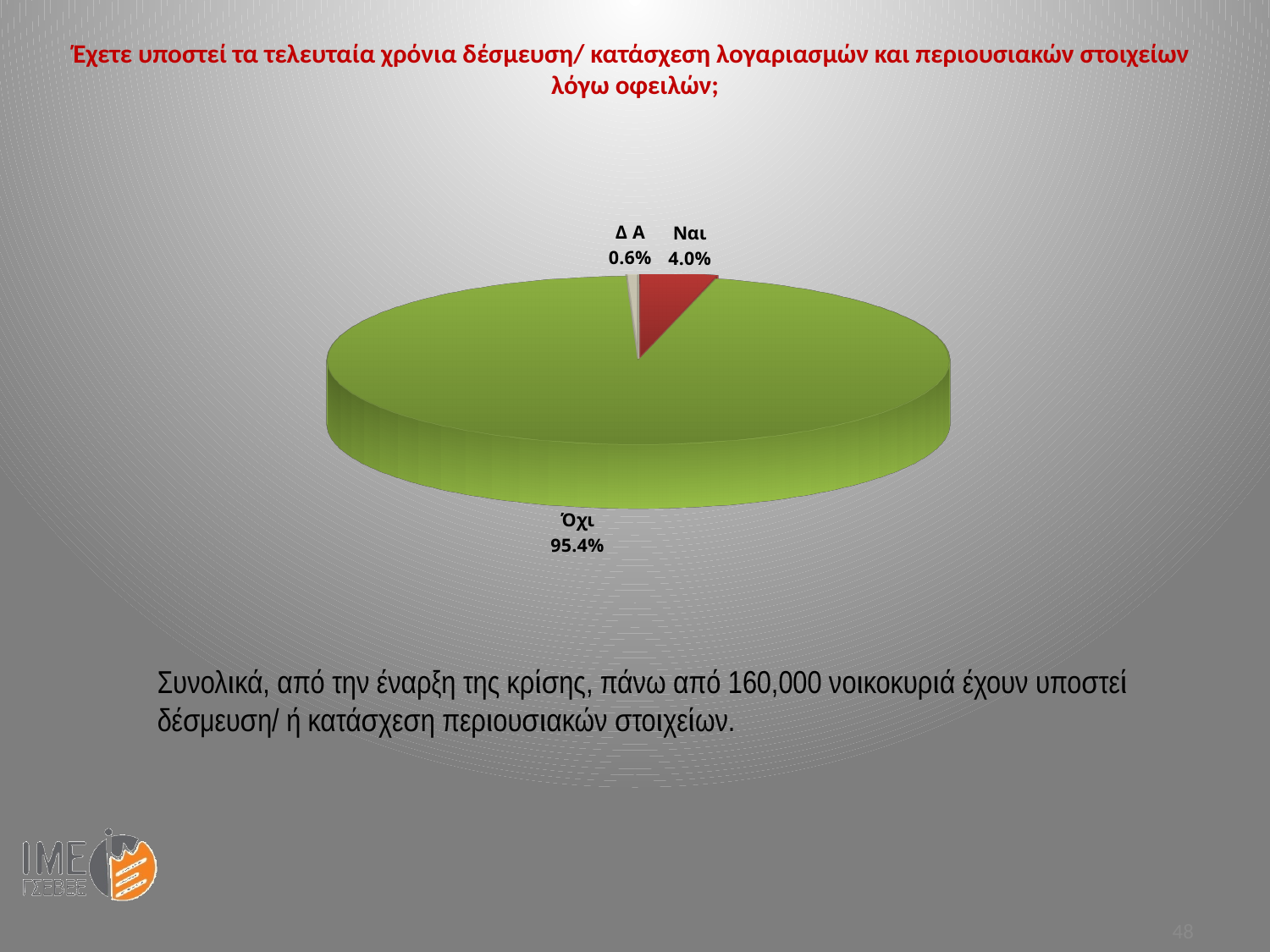
What colour is the Ναι slice of the pie? Red What percentage is shown for Όχι? 95.4% What kind of chart is shown on the slide? Pie chart Which category has the largest share of the pie? Όχι What is the difference in percentage points between Ναι and Δ Α? 3.4 Which category has the smallest share of the pie? Δ Α What percentage is shown for Δ Α? 0.6% What percentage is shown for Ναι? 4.0% How many slices does the pie chart have? 3 What is the difference in percentage points between Όχι and Ναι? 91.4 What colour is the Όχι slice of the pie? Green Which is larger, the share for Ναι or the share for Δ Α? Ναι